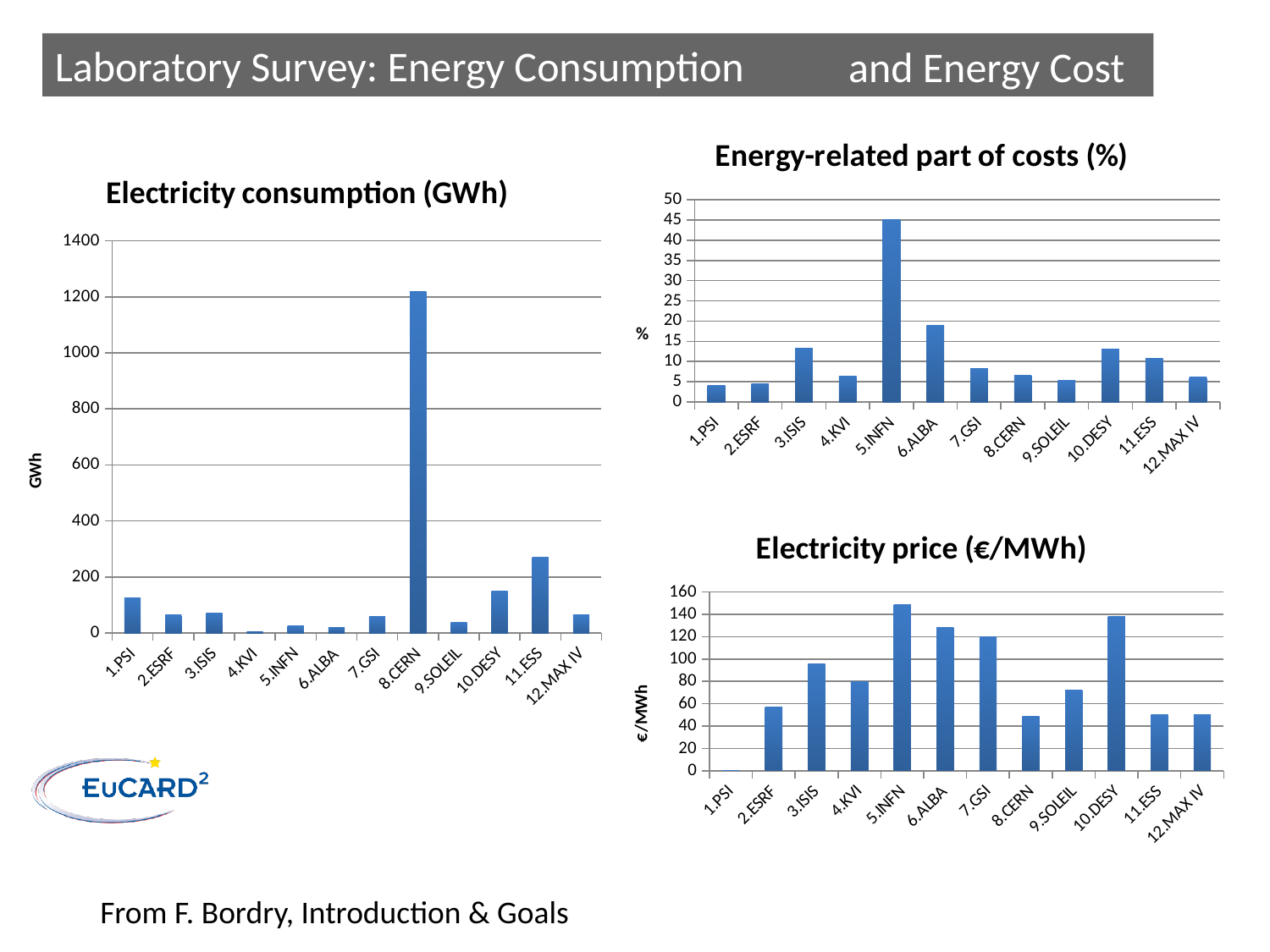
In the Electricity price (€/MWh) chart, is the value for 10.DESY greater or less than 120? greater In the Electricity consumption (GWh) chart, is the value for 8.CERN greater or less than 1000? greater In the Electricity consumption (GWh) chart, which has the larger value, 10.DESY or 2.ESRF? 10.DESY In the Electricity consumption (GWh) chart, is the value for 11.ESS greater or less than 200? greater In the Energy-related part of costs (%) chart, which has the larger value, 6.ALBA or 7.GSI? 6.ALBA In the Electricity price (€/MWh) chart, which laboratory has the highest electricity price? 5.INFN How many laboratories are shown on the x axis of the Electricity consumption (GWh) chart? 12 What kind of chart is the Electricity consumption (GWh) chart? bar chart In the Electricity consumption (GWh) chart, which laboratory has the highest electricity consumption? 8.CERN In the Energy-related part of costs (%) chart, which laboratory has the highest value? 5.INFN In the Electricity price (€/MWh) chart, which laboratory has the lowest electricity price? 1.PSI